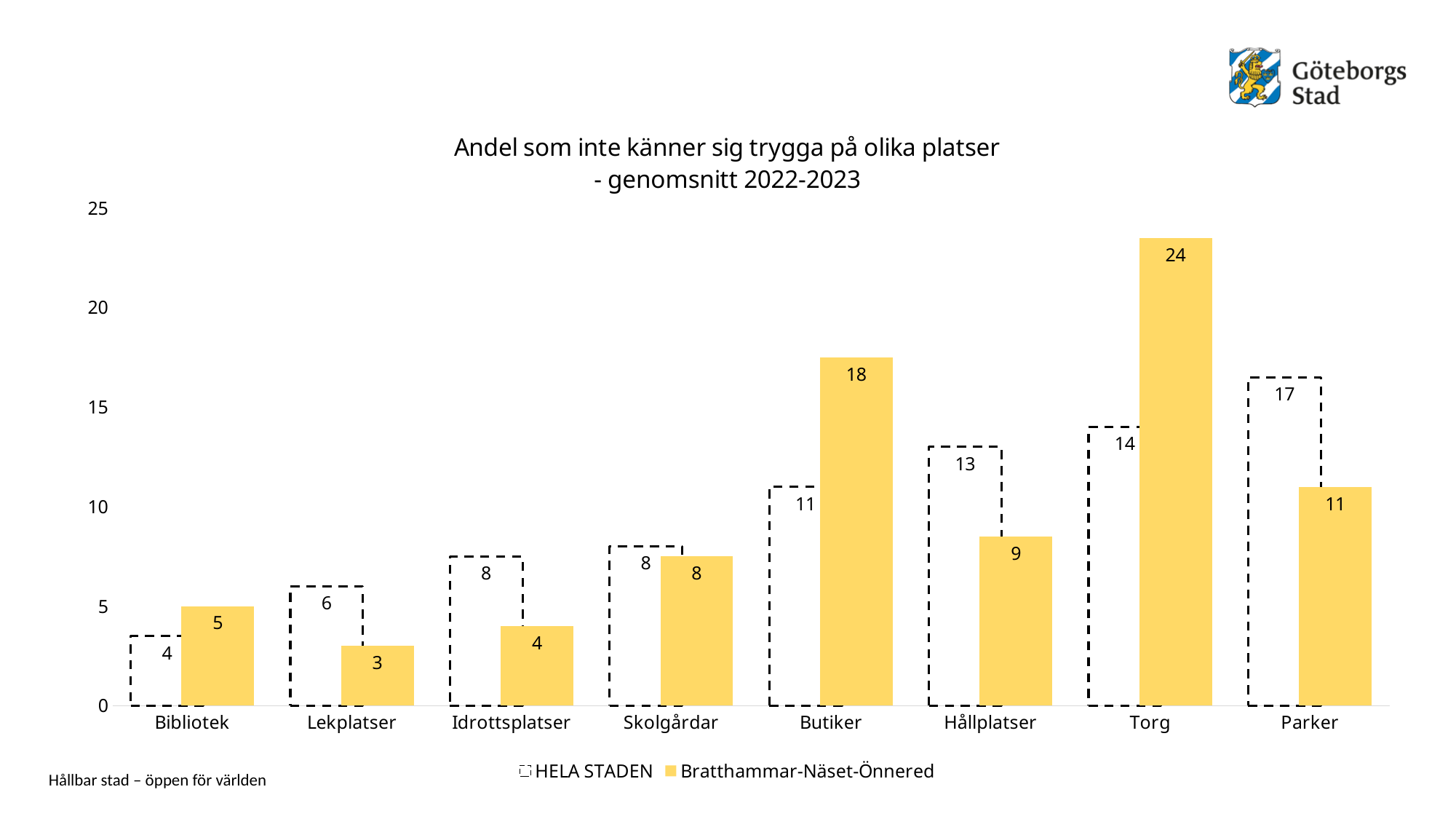
What is the difference between the Bratthammar-Näset-Önnered value and the HELA STADEN value at Torg? 10 What kind of chart is shown on the slide? Bar chart At Parker, which series has the larger value, HELA STADEN or Bratthammar-Näset-Önnered? HELA STADEN Which category has the highest value for Bratthammar-Näset-Önnered? Torg Is the value for Bratthammar-Näset-Önnered at Butiker greater or less than 15? greater How many categories are shown on the x axis? 8 What is the value for Bratthammar-Näset-Önnered at Torg? 24 How many series does the legend list? 2 What is the value for HELA STADEN at Butiker? 11 Which category has the lowest value for Bratthammar-Näset-Önnered? Lekplatser What is the value for Bratthammar-Näset-Önnered at Lekplatser? 3 What is the value for HELA STADEN at Parker? 17